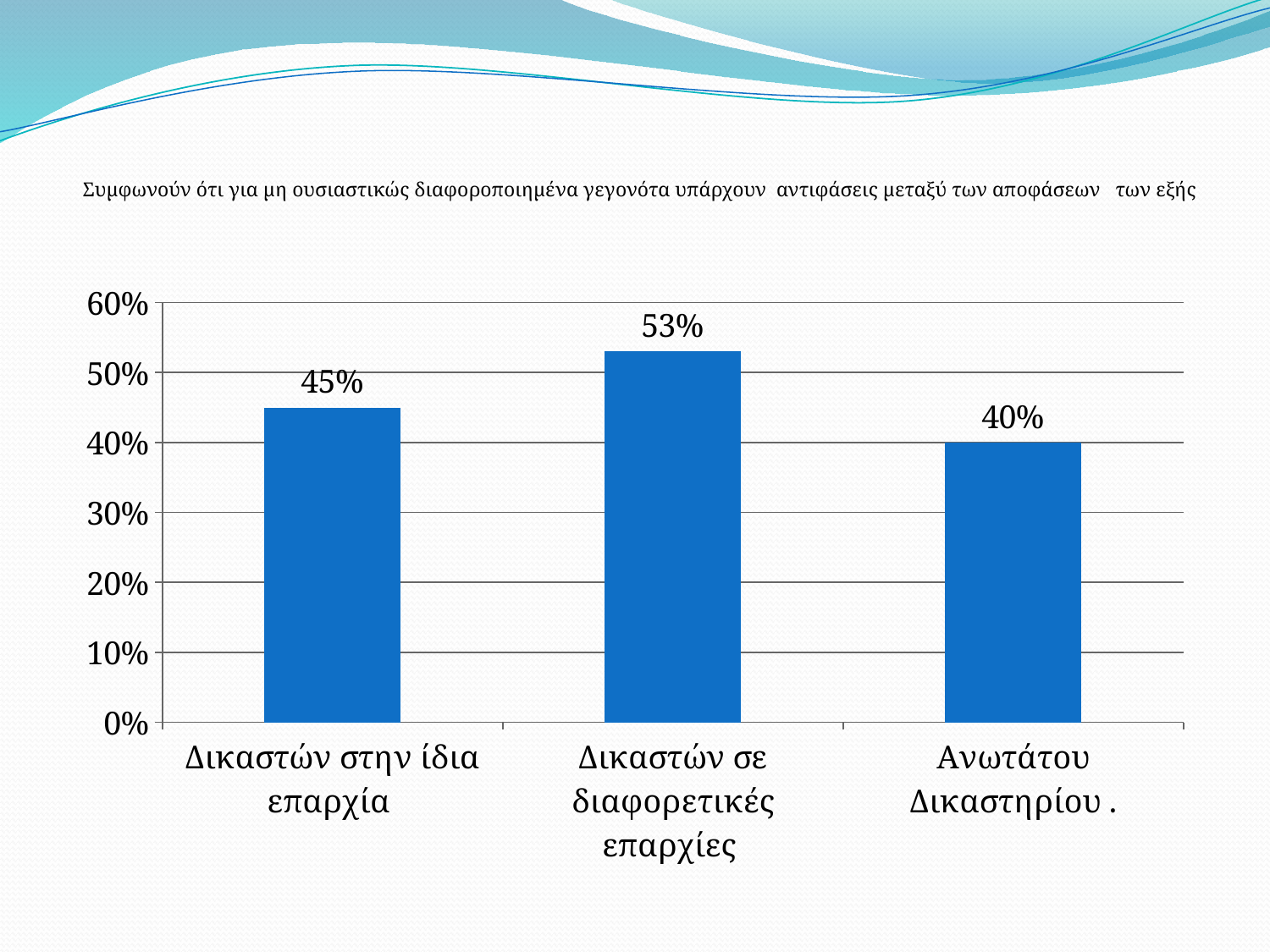
Which category has the lowest value? Ανωτάτου Δικαστηρίου Which is larger: the value for Δικαστών στην ίδια επαρχία or for Δικαστών σε διαφορετικές επαρχίες? Δικαστών σε διαφορετικές επαρχίες What is the difference between the values for Δικαστών στην ίδια επαρχία and Ανωτάτου Δικαστηρίου? 5% What is the value for Δικαστών στην ίδια επαρχία? 45% What is the value for Δικαστών σε διαφορετικές επαρχίες? 53% What is the value for Ανωτάτου Δικαστηρίου? 40% What is the maximum value shown on the y axis? 60% What kind of chart is shown on the slide? bar chart Is the value for Δικαστών σε διαφορετικές επαρχίες greater or less than 50%? greater Which category has the highest value? Δικαστών σε διαφορετικές επαρχίες How many categories are shown on the x axis? 3 What is the difference between the values for Δικαστών σε διαφορετικές επαρχίες and Ανωτάτου Δικαστηρίου? 13%